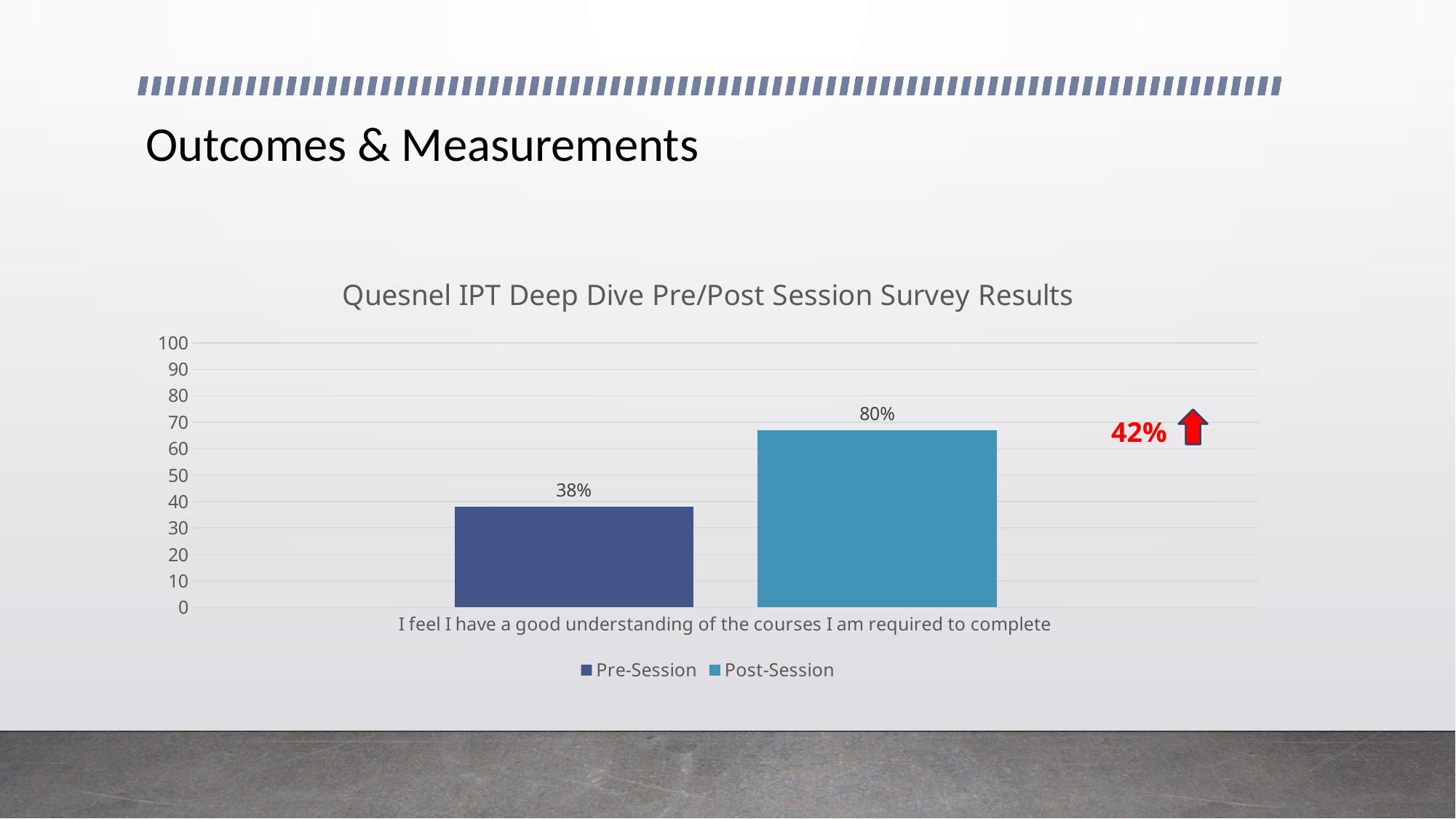
How many series does the legend list? 2 What is the difference between the Post-Session and Pre-Session values? 42% Which series is shown in the darker blue colour? Pre-Session What is the Post-Session value for "I feel I have a good understanding of the courses I am required to complete"? 80% What is the highest value shown on the y axis? 100 Which series has the lowest value? Pre-Session What kind of chart is shown on the slide? Bar chart What is the title of the chart? Quesnel IPT Deep Dive Pre/Post Session Survey Results What is the Pre-Session value for "I feel I have a good understanding of the courses I am required to complete"? 38% Which series has the highest value? Post-Session Which series has the higher value, Pre-Session or Post-Session? Post-Session How many categories are shown on the x axis? 1